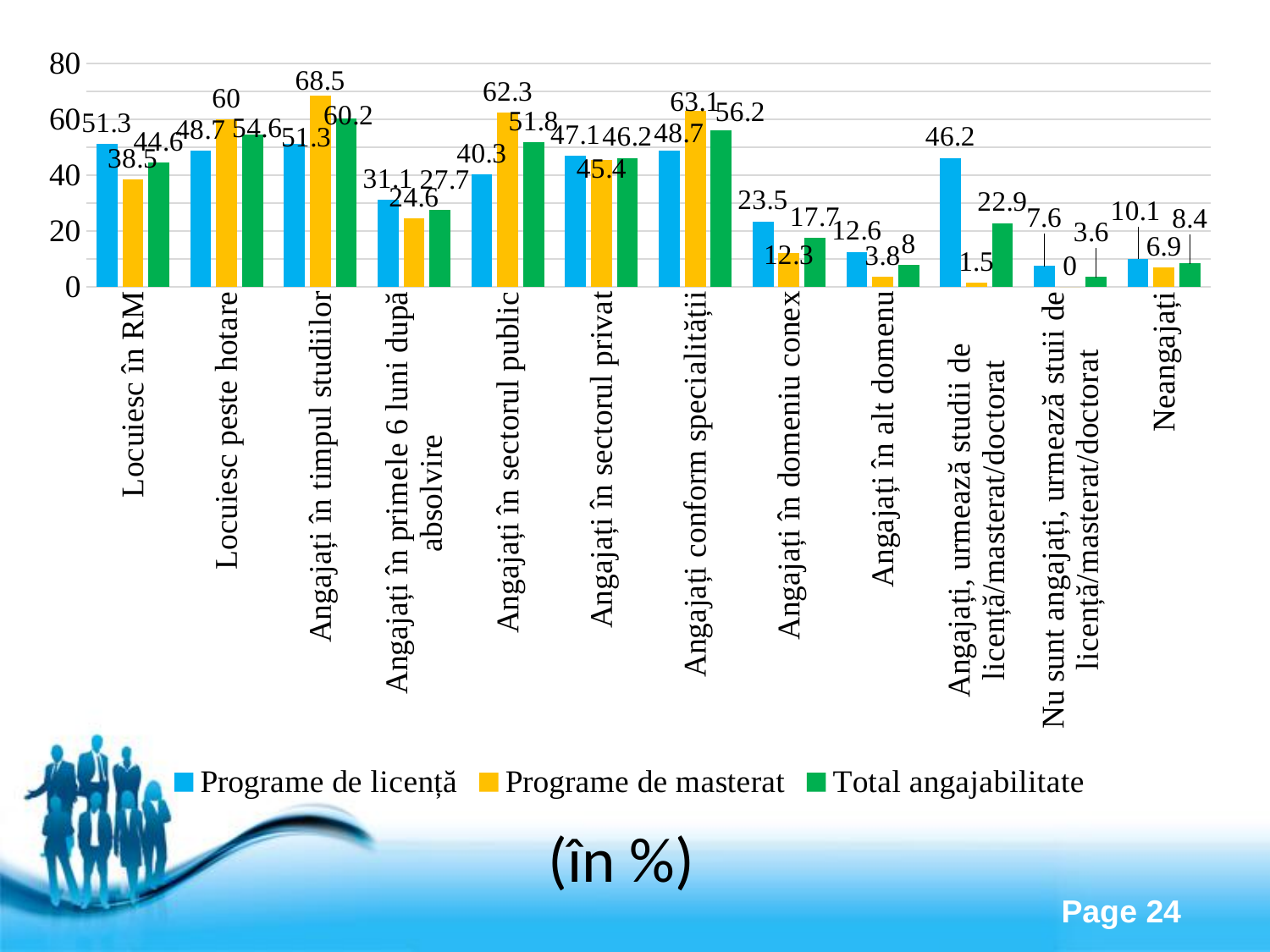
What is the value for Programe de masterat in the category Angajați în timpul studiilor? 68.5 Is the Programe de masterat value for Angajați în timpul studiilor greater or less than 60? greater Which category has the lowest value for Programe de licență? Nu sunt angajați, urmează stuii de licență/masterat/doctorat What kind of chart is shown on the slide? Bar chart What is the difference between the Programe de masterat and Programe de licență values for Angajați în sectorul public? 22 What is the value for Programe de masterat in the category Nu sunt angajați, urmează stuii de licență/masterat/doctorat? 0 What is the Total angajabilitate value for Angajați conform specialității? 56.2 Which category has the highest value for Programe de masterat? Angajați în timpul studiilor How many categories are shown on the x axis? 12 How many series does the legend list? 3 Which is larger for Angajați în domeniu conex: Programe de licență or Programe de masterat? Programe de licență What is the value for Programe de licență in the category Angajați în sectorul public? 40.3